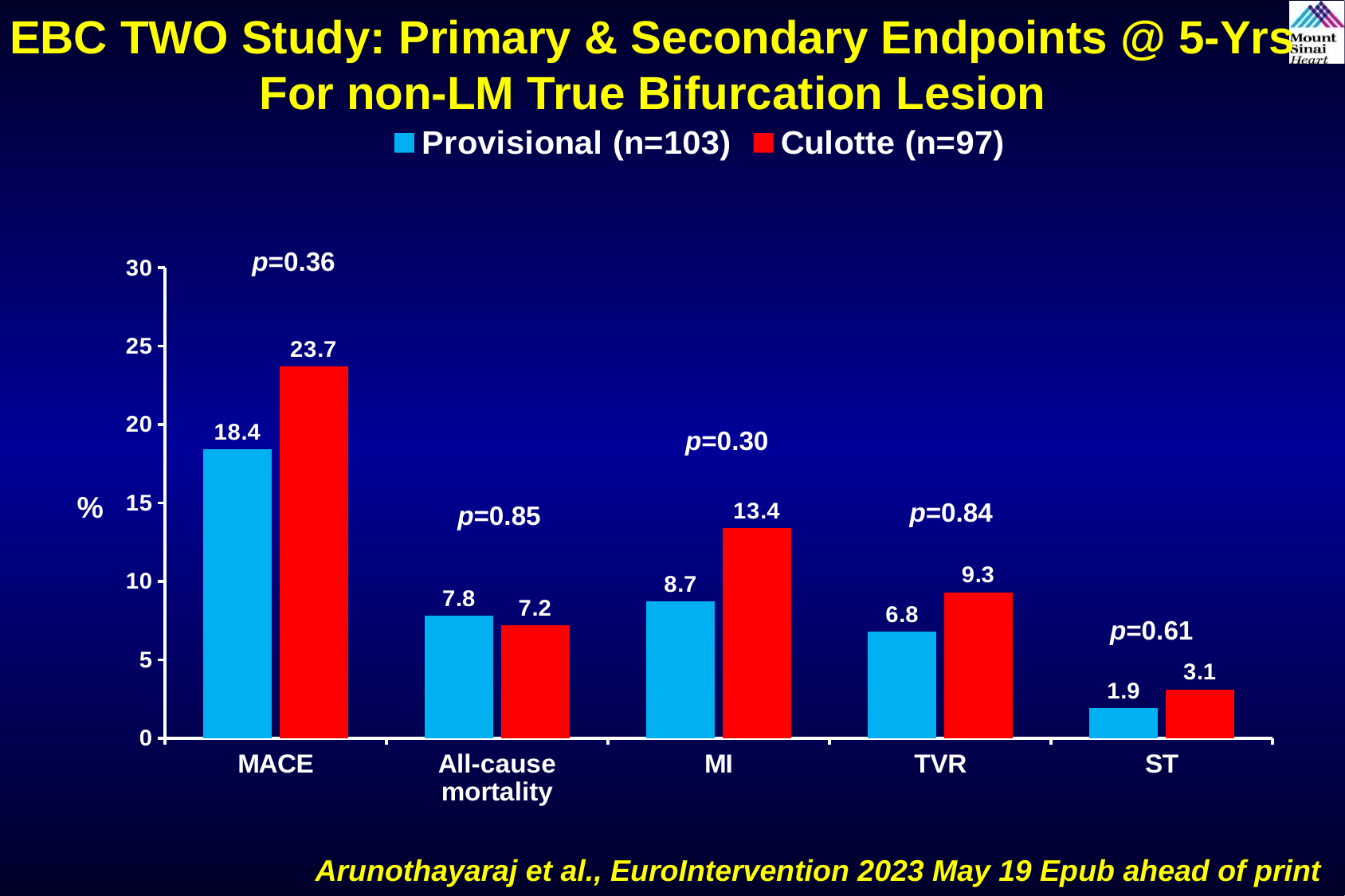
What kind of chart is shown on the slide? bar chart For All-cause mortality, which group has the larger value, Provisional or Culotte? Provisional What is the MACE rate for the Culotte (n=97) group? 23.7 What is the MI rate for the Provisional (n=103) group? 8.7 How many endpoint categories are shown on the x axis? 5 What is the ST rate for the Culotte (n=97) group? 3.1 Is the TVR value for the Culotte (n=97) group greater or less than 10? less Which endpoint has the highest value for the Provisional (n=103) group? MACE Which endpoint has the lowest value for the Culotte (n=97) group? ST How many series does the legend list? 2 What is the difference between the Culotte and Provisional MACE rates? 5.3 What p-value is shown above the MI bars? p=0.30